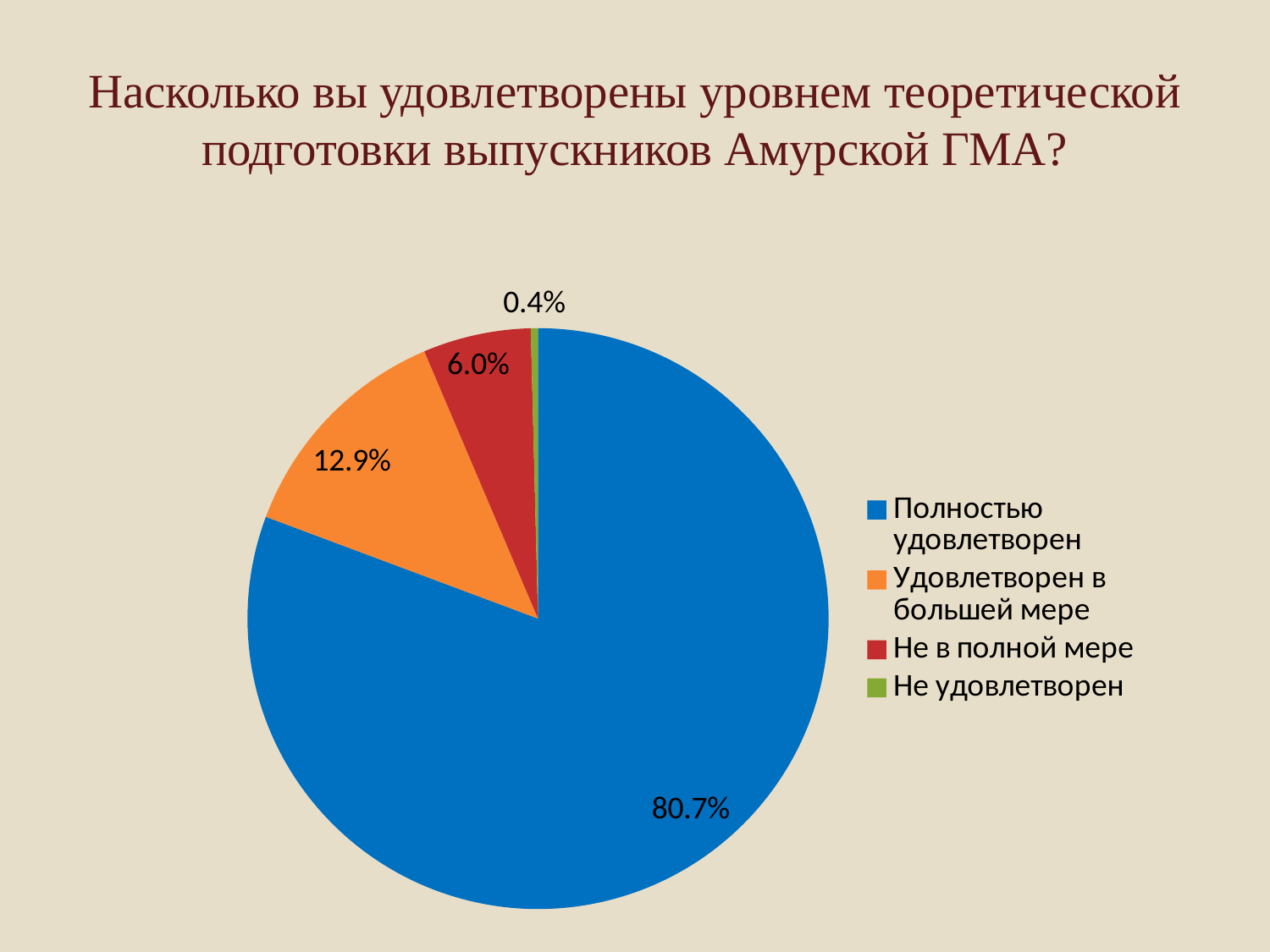
What is the difference between the shares for "Полностью удовлетворен" and "Удовлетворен в большей мере"? 67.8% Which category has the largest slice of the pie? Полностью удовлетворен What share of respondents answered "Удовлетворен в большей мере"? 12.9% Which category has the smallest slice of the pie? Не удовлетворен What share of respondents answered "Не в полной мере"? 6.0% What kind of chart is shown on the slide? pie chart What colour is the slice for "Не в полной мере"? red What is the difference between the shares for "Удовлетворен в большей мере" and "Не в полной мере"? 6.9% What share of respondents answered "Не удовлетворен"? 0.4% How many categories does the legend list? 4 What share of respondents answered "Полностью удовлетворен"? 80.7% Which is larger: the share for "Не в полной мере" or the share for "Не удовлетворен"? Не в полной мере